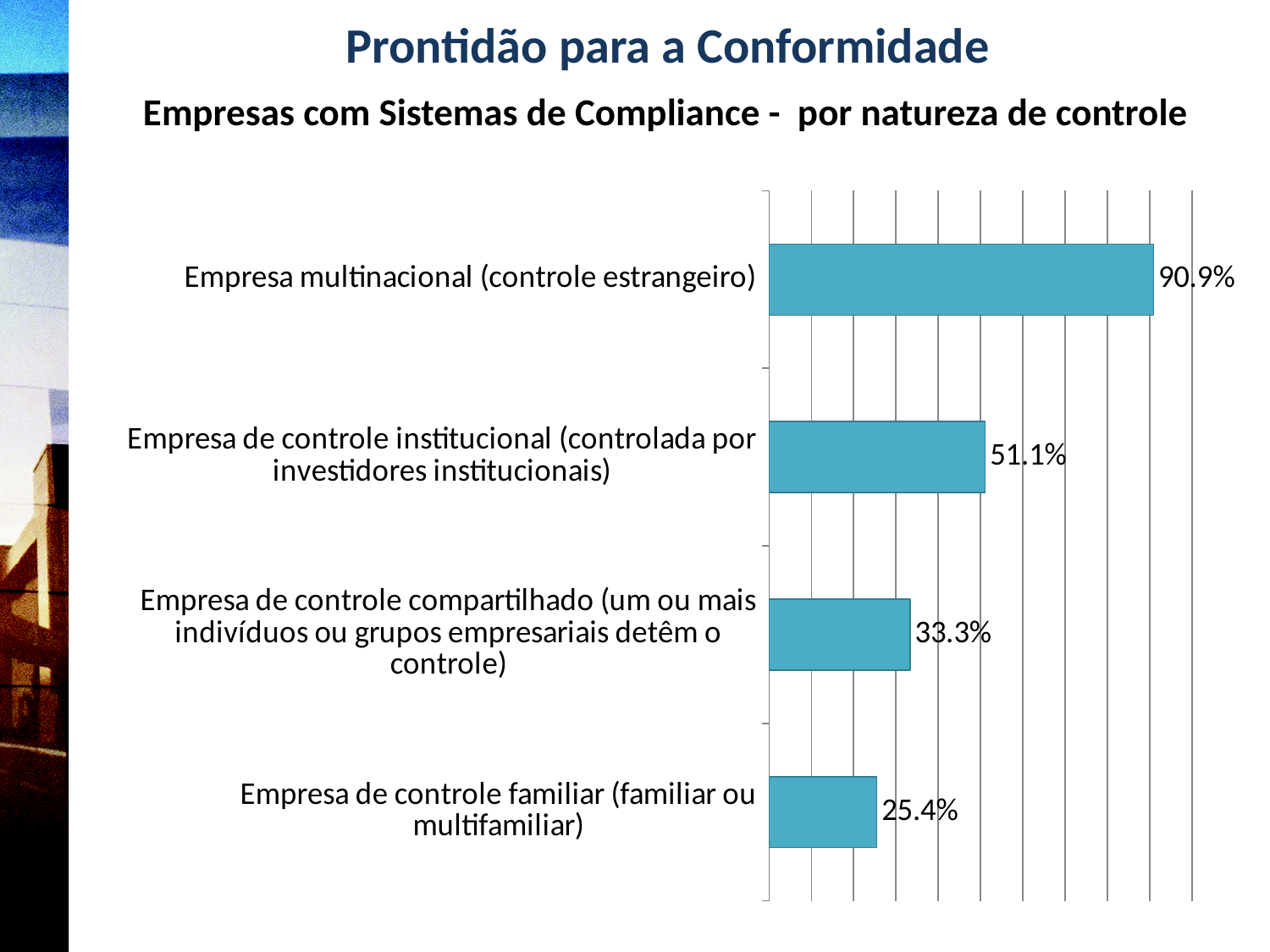
Which category has the lowest value? Empresa de controle familiar (familiar ou multifamiliar) What is the value for Empresa de controle compartilhado? 33.3% What is the subtitle of the chart on the slide? Empresas com Sistemas de Compliance - por natureza de controle What is the value for Empresa de controle institucional (controlada por investidores institucionais)? 51.1% What is the value for Empresa multinacional (controle estrangeiro)? 90.9% What is the value for Empresa de controle familiar (familiar ou multifamiliar)? 25.4% What is the difference between the values for Empresa multinacional (controle estrangeiro) and Empresa de controle familiar (familiar ou multifamiliar)? 65.5% What kind of chart is shown on the slide? Bar chart How many categories are shown in the chart? 4 Which is larger, the value for Empresa de controle institucional or the value for Empresa de controle compartilhado? Empresa de controle institucional Which category has the highest value? Empresa multinacional (controle estrangeiro) What is the difference between the values for Empresa de controle institucional and Empresa de controle compartilhado? 17.8%